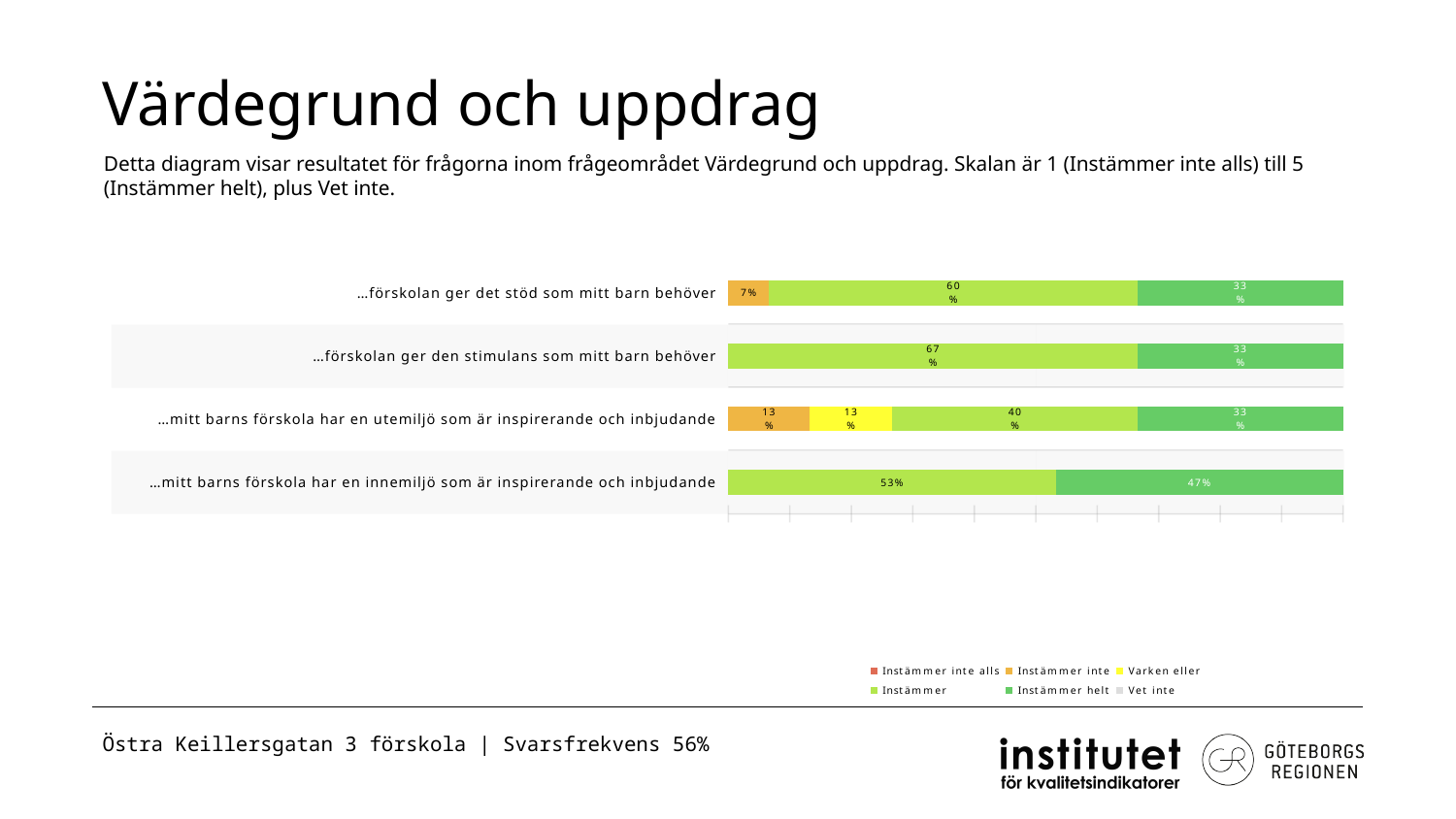
What is the 'Instämmer helt' share for '…mitt barns förskola har en innemiljö som är inspirerande och inbjudande'? 47% Which statement has the lowest 'Instämmer' share? …mitt barns förskola har en utemiljö som är inspirerande och inbjudande Which statement has the highest 'Instämmer' share? …förskolan ger den stimulans som mitt barn behöver What is the 'Varken eller' share for '…mitt barns förskola har en utemiljö som är inspirerande och inbjudande'? 13% Which legend entry is shown in yellow? Varken eller How many statements (categories) are plotted in the chart? 4 What is the difference between the 'Instämmer' share for '…förskolan ger det stöd som mitt barn behöver' and for '…mitt barns förskola har en utemiljö som är inspirerande och inbjudande'? 20 percentage points How many series does the legend list? 6 What is the 'Instämmer inte' share for '…förskolan ger det stöd som mitt barn behöver'? 7% What kind of chart is shown on the slide? Stacked bar chart What is the 'Instämmer' share for '…förskolan ger den stimulans som mitt barn behöver'? 67% Which is larger: the 'Instämmer helt' share for '…mitt barns förskola har en innemiljö som är inspirerande och inbjudande' or for '…förskolan ger det stöd som mitt barn behöver'? …mitt barns förskola har en innemiljö som är inspirerande och inbjudande